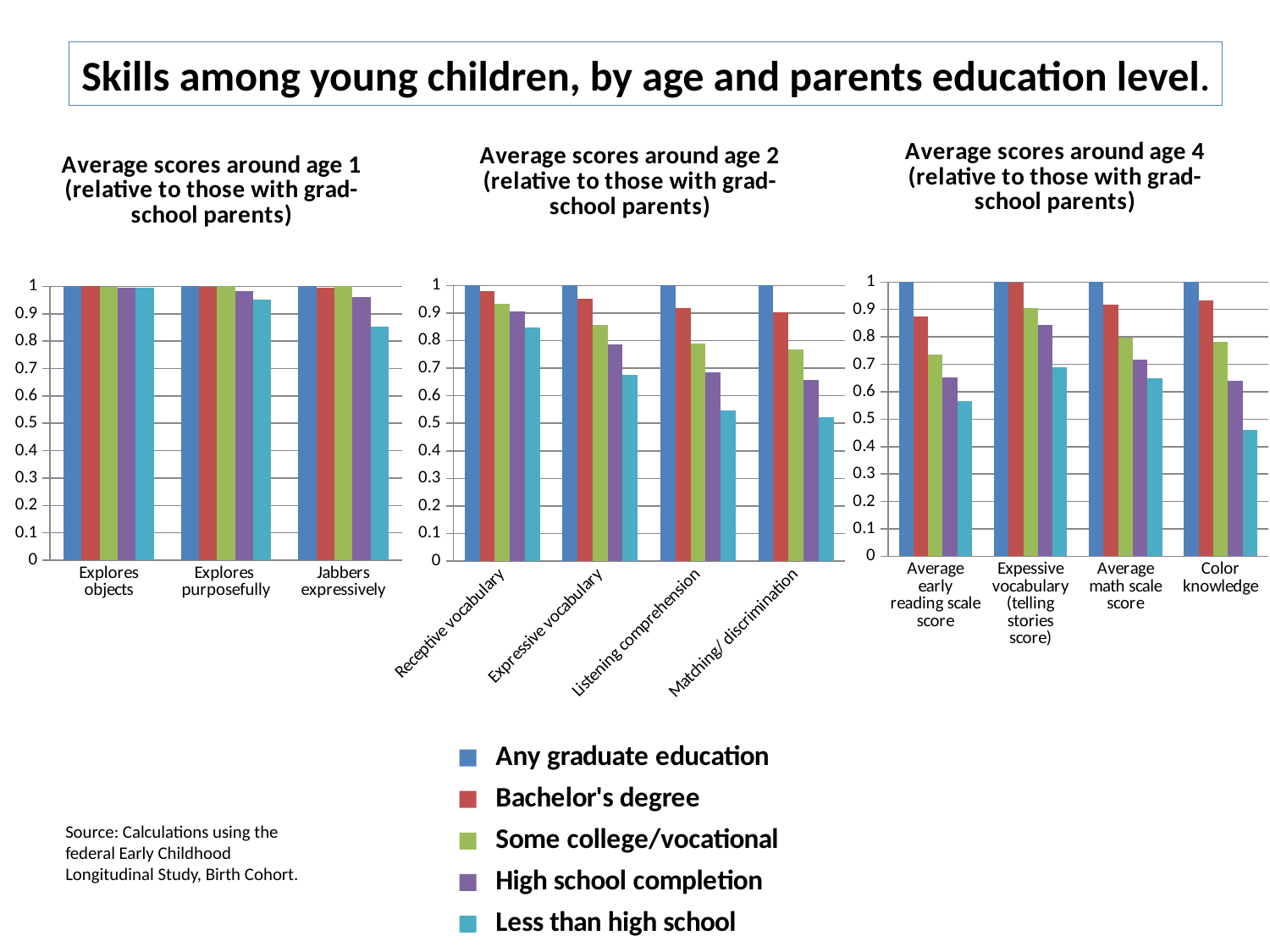
In the 'Average scores around age 2' chart, is the value for Less than high school for Expressive vocabulary greater or less than 0.6? greater What kind of chart is the 'Average scores around age 1' chart? bar chart In the 'Average scores around age 2' chart, do the Less than high school values rise or fall from left to right along the x axis? fall In the 'Average scores around age 2' chart, which is larger for Bachelor's degree: Receptive vocabulary or Matching/ discrimination? Receptive vocabulary How many series does the legend list? 5 In the 'Average scores around age 4' chart, what is the value for Any graduate education for Color knowledge? 1 In the 'Average scores around age 4' chart, is the value for Less than high school for Color knowledge greater or less than 0.5? less How many categories are shown on the 'Average scores around age 2' chart? 4 What colour represents Bachelor's degree in the legend? red In the 'Average scores around age 4' chart, which category has the highest value for Bachelor's degree? Expessive vocabulary (telling stories score) How many categories are shown on the 'Average scores around age 1' chart? 3 In the 'Average scores around age 4' chart, which category has the lowest value for Less than high school? Color knowledge